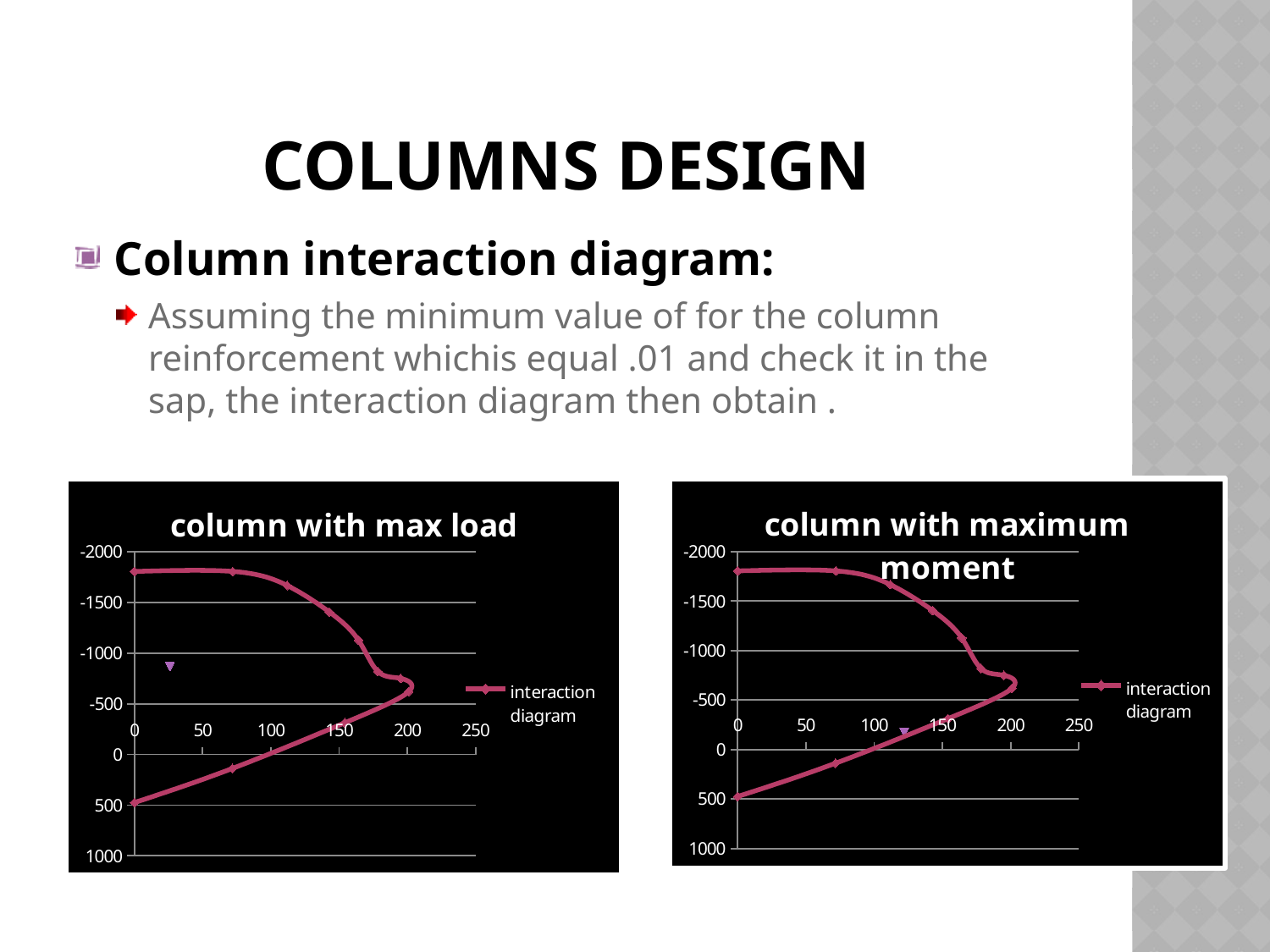
In the 'column with max load' chart, is the x position of the single triangle marker greater or less than 50? less How many charts are shown on the slide? 2 In the 'column with maximum moment' chart, is the x position of the single triangle marker greater or less than 100? greater How many series does the legend of the 'column with maximum moment' chart list? 1 What is the name of the series shown in the legend of the 'column with max load' chart? interaction diagram What kind of chart is the 'column with max load' chart? line chart In the 'column with maximum moment' chart, is the largest x value reached by the interaction diagram curve greater or less than 150? greater What is the title of the chart on the right side of the slide? column with maximum moment